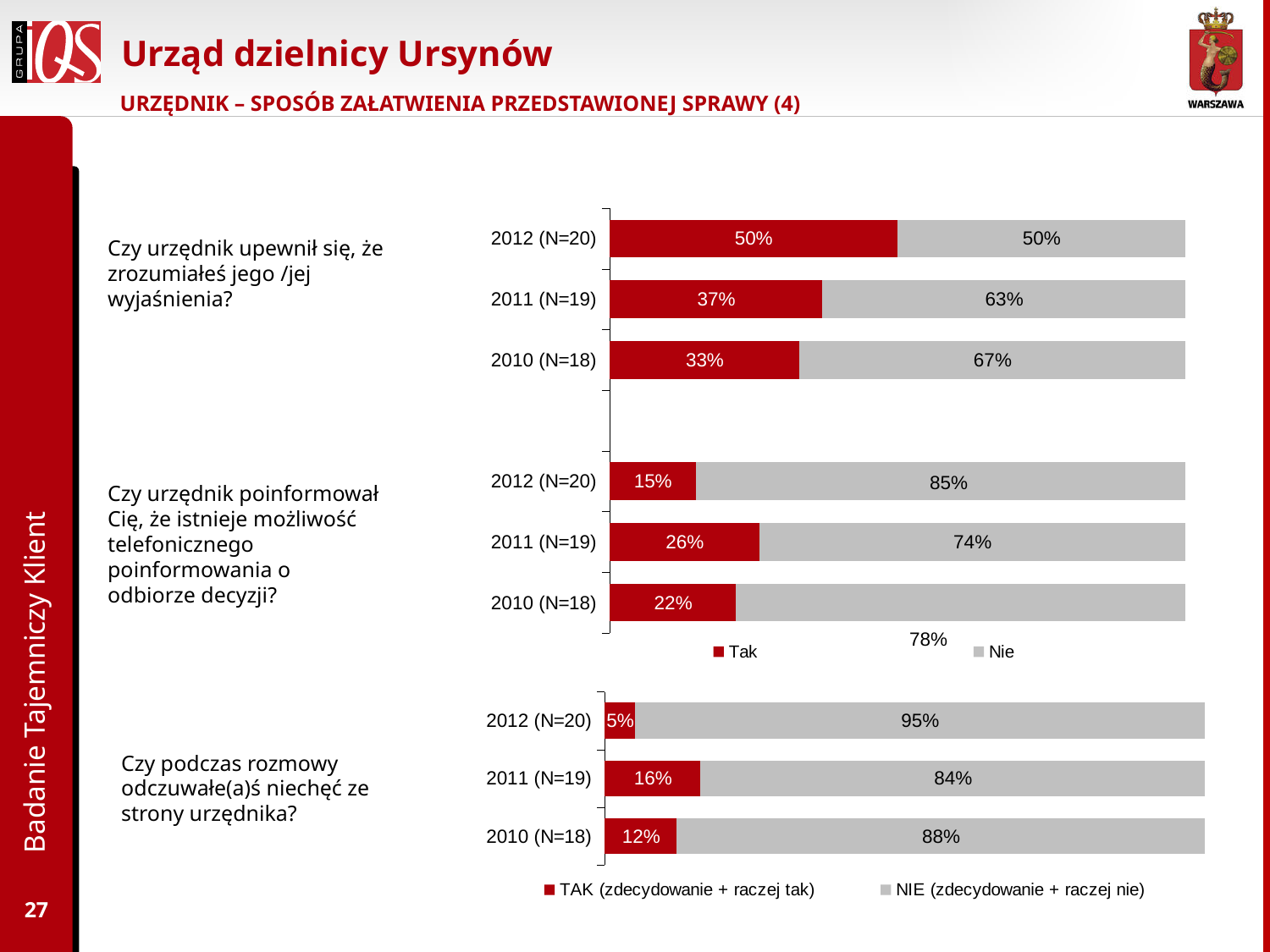
What kind of chart is used on this slide? Stacked bar chart In the bottom chart ("Czy podczas rozmowy odczuwałe(a)ś niechęć..."), which year has the highest "TAK" value? 2011 (N=19) In the bottom chart ("Czy podczas rozmowy odczuwałe(a)ś niechęć ze strony urzędnika?"), what is the "TAK" value for 2012 (N=20)? 5% In the top chart ("Czy urzędnik upewnił się..."), what is the "Nie" value for 2010 (N=18)? 67% In the top chart ("Czy urzędnik upewnił się..."), which year has the highest "Tak" value? 2012 (N=20) In the middle chart ("Czy urzędnik poinformował Cię..."), which year has the lowest "Tak" value? 2012 (N=20) In the top chart ("Czy urzędnik upewnił się..."), what is the difference between the "Tak" values for 2012 (N=20) and 2010 (N=18)? 17 percentage points In the top chart ("Czy urzędnik upewnił się, że zrozumiałeś jego/jej wyjaśnienia?"), what is the "Tak" value for 2012 (N=20)? 50% In the middle chart ("Czy urzędnik poinformował Cię..."), is the "Nie" value larger for 2012 (N=20) or 2011 (N=19)? 2012 (N=20) In the middle chart ("Czy urzędnik poinformował Cię..."), what is the "Tak" value for 2011 (N=19)? 26% In the bottom chart ("Czy podczas rozmowy odczuwałe(a)ś niechęć..."), what is the total of the stacked bar for 2010 (N=18)? 100% How many series does the legend of the bottom chart list? 2